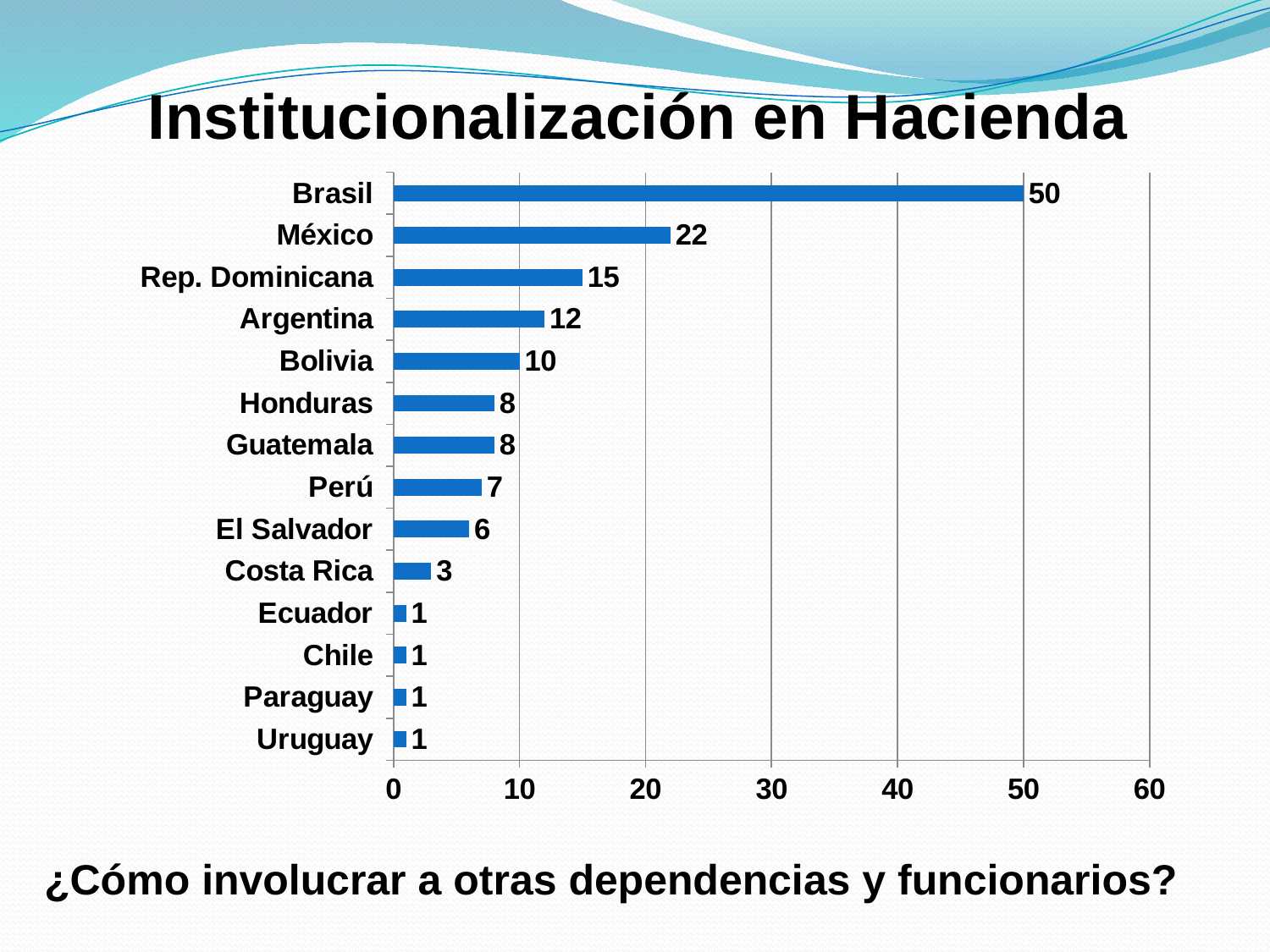
What is the difference between the values for Argentina and Bolivia? 2 How many countries have a value of 1? 4 What is the difference between the values for Brasil and México? 28 How many countries are shown in the chart? 14 What is the value for Costa Rica? 3 What kind of chart is shown on the slide? Bar chart Which country has the highest value? Brasil What is the value for Rep. Dominicana? 15 What is the title of the slide? Institucionalización en Hacienda Is the value for México greater or less than 20? greater Which has a larger value, Perú or El Salvador? Perú What is the value for Brasil? 50